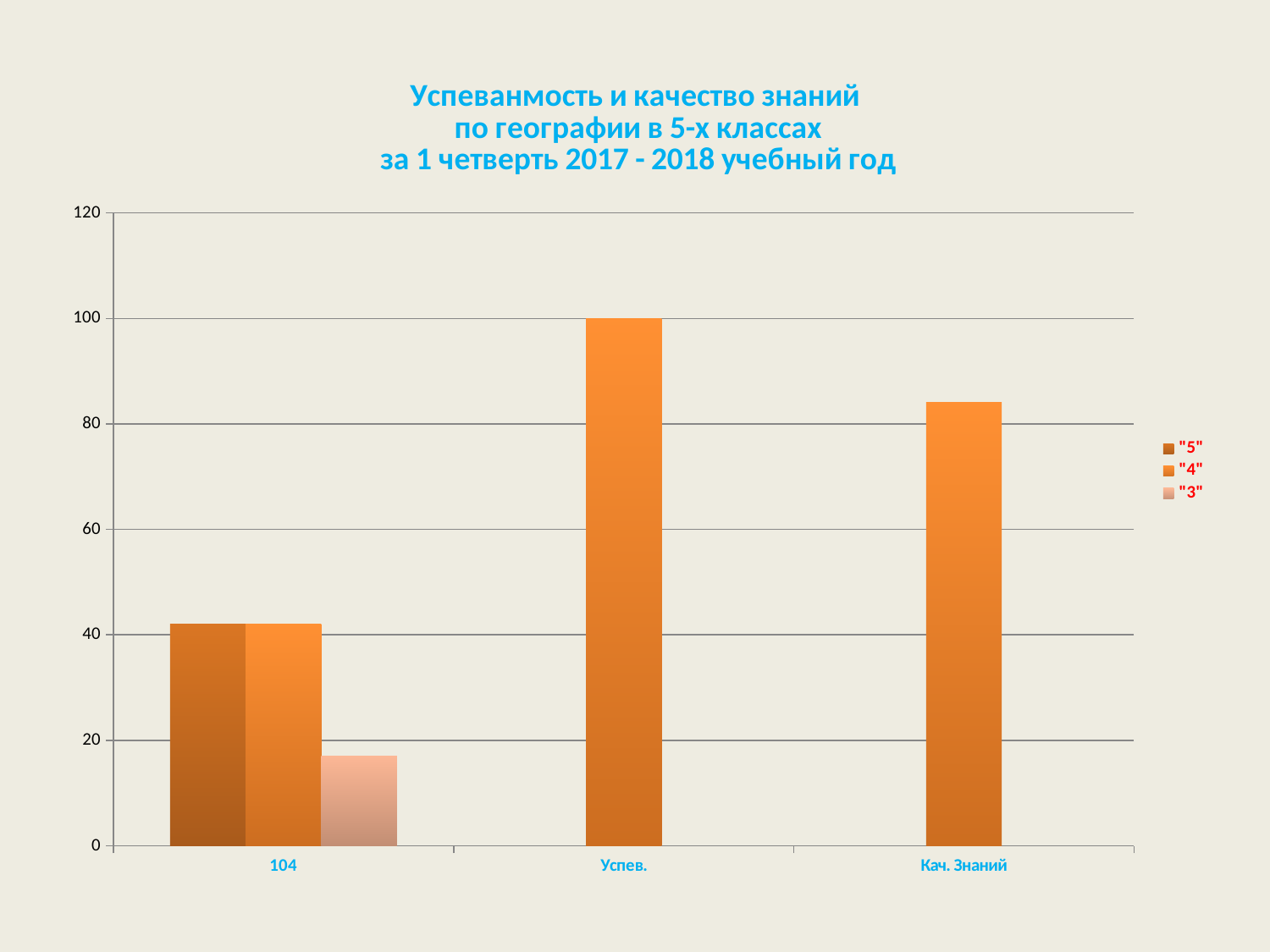
Is the value for the category Кач. Знаний greater or less than 80? greater Is the value of the "3" series for the category 104 greater or less than 20? less Which series has the lowest bar in the category 104? "3" Which category has the tallest bar? Успев. Which is larger, the bar for Успев. or the bar for Кач. Знаний? Успев. How many categories are shown on the x axis? 3 What kind of chart is shown on the slide? bar chart How many series does the legend list? 3 Which series is shown in the lightest colour in the legend? "3" What is the value of the "4" series for the category Успев.? 100 What are the entries listed in the legend? "5", "4", "3" Is the value of the "5" series for the category 104 greater or less than 40? greater